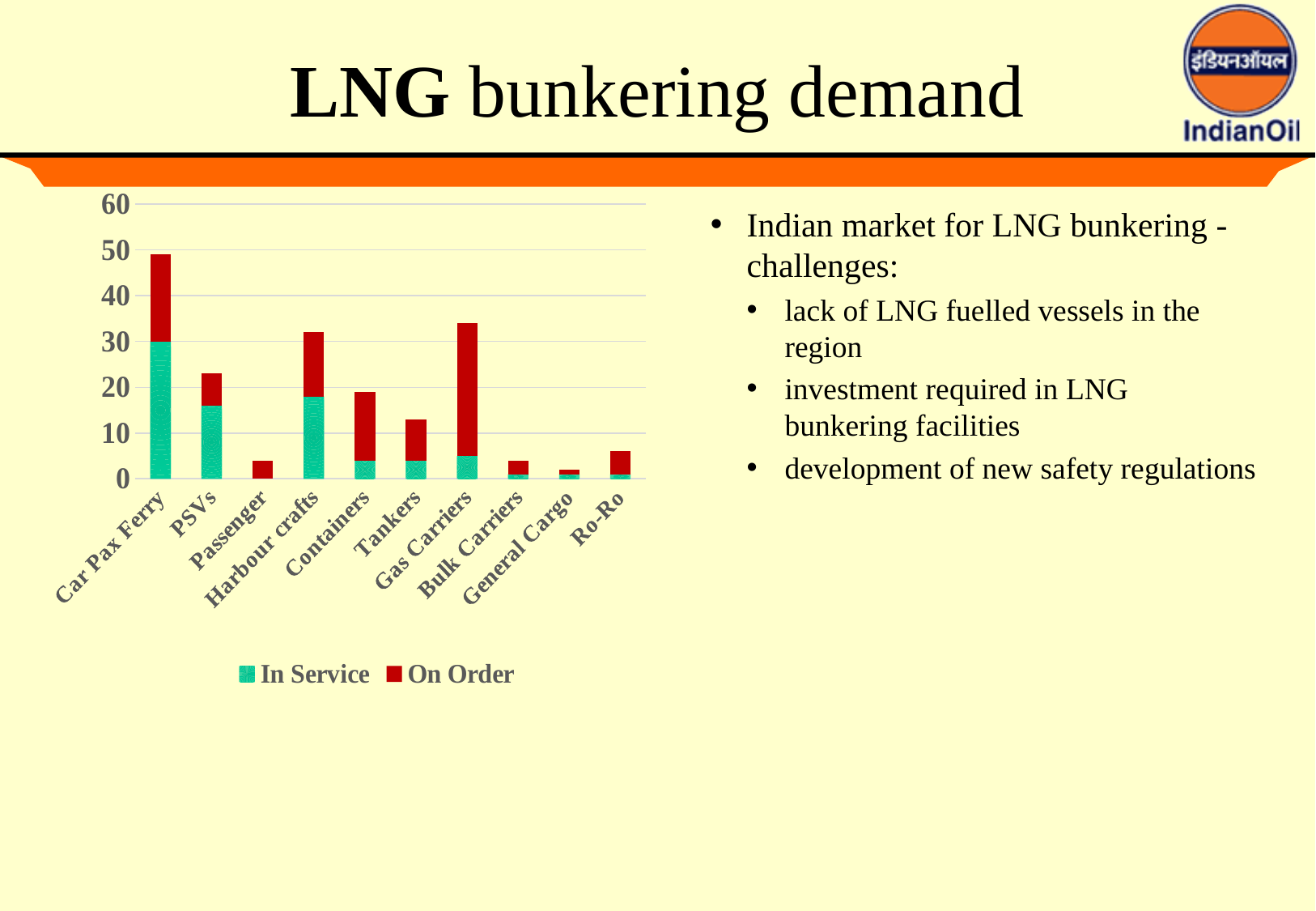
Is the total bar for PSVs greater or less than 30? less Which has the larger total bar, Harbour crafts or Tankers? Harbour crafts Is the total bar for Car Pax Ferry greater or less than 40? greater Is the total bar for Ro-Ro greater or less than 10? less How many series does the chart legend list? 2 Which category has the highest total bar in the chart? Car Pax Ferry Which category has the largest On Order segment? Gas Carriers What kind of chart is shown on the slide? Stacked bar chart How many vessel categories are shown on the x axis of the chart? 10 Which has the larger In Service segment, Car Pax Ferry or Harbour crafts? Car Pax Ferry What colour represents the On Order series in the chart? Red